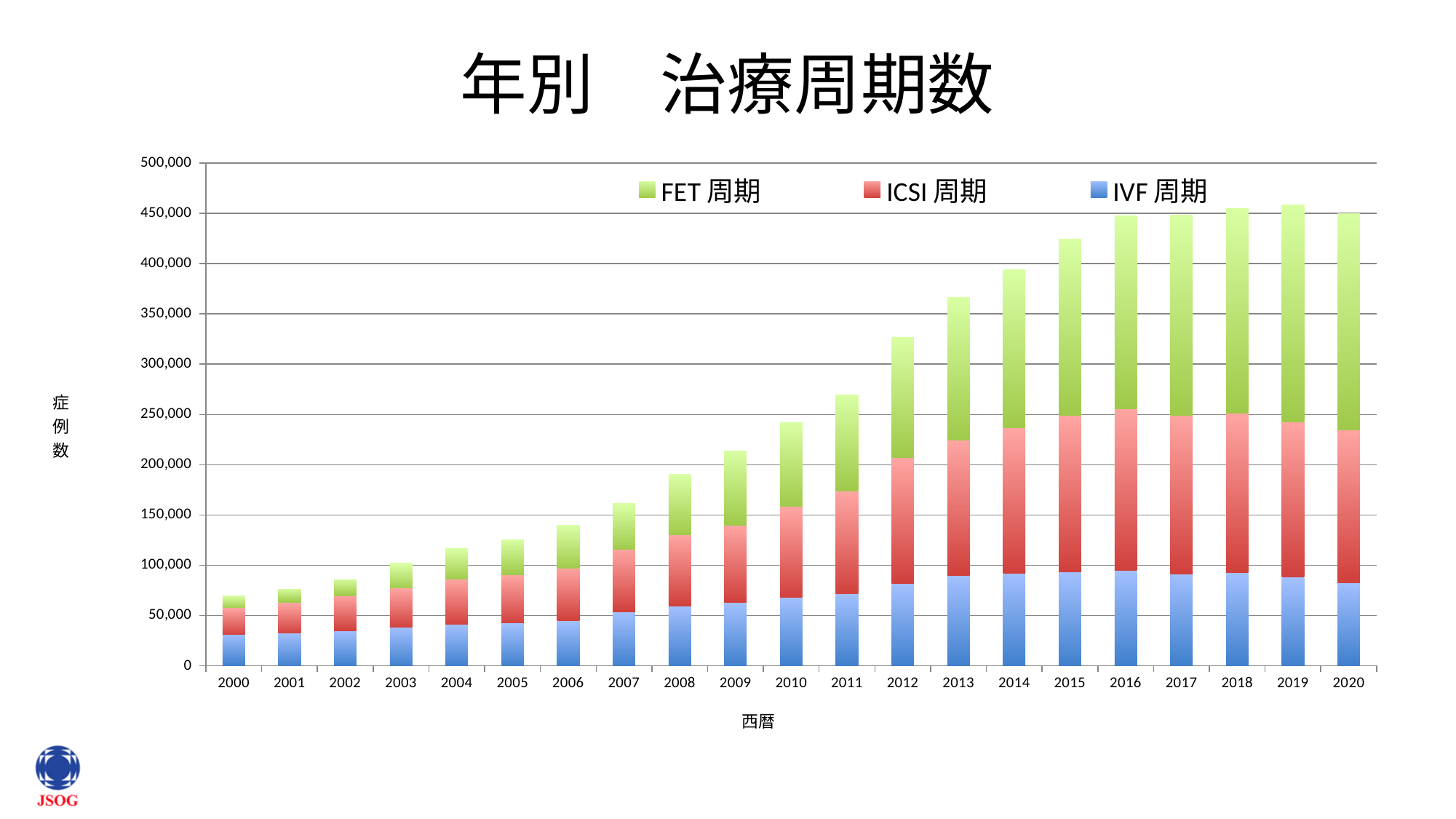
What is the title of the chart? 年別 治療周期数 Do the total treatment cycle counts generally rise or fall from 2000 to 2019? rise Which year has the lowest total number of treatment cycles? 2000 Is the total stacked value for 2020 greater or less than 400,000? greater How many series does the legend list? 3 Is the total stacked value for 2012 greater or less than 300,000? greater What kind of chart is shown on the slide? Stacked bar chart How many years are shown along the x axis? 21 Which series is shown in green in the legend? FET 周期 Is the total stacked value for 2000 greater or less than 100,000? less Which year has the larger total number of cycles, 2010 or 2015? 2015